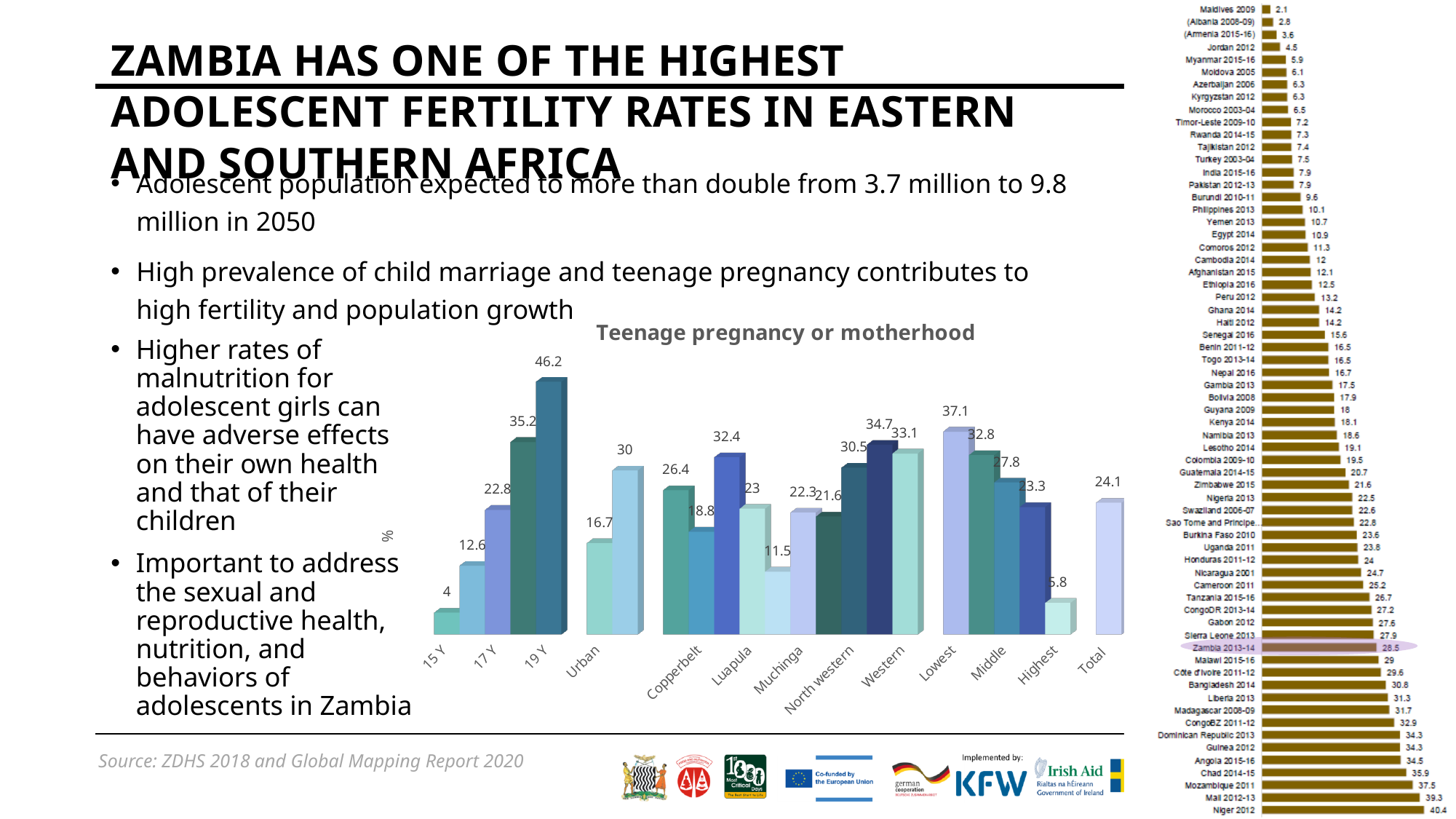
In the 'Teenage pregnancy or motherhood' chart, which category has the highest value? 19 Y What is the title of the bar chart in the centre of the slide? Teenage pregnancy or motherhood In the 'Teenage pregnancy or motherhood' chart, what is the value for Urban? 16.7 In the 'Teenage pregnancy or motherhood' chart, what is the value for 15 Y? 4 In the 'Teenage pregnancy or motherhood' chart, what is the difference between the values for 19 Y and 15 Y? 42.2 In the 'Teenage pregnancy or motherhood' chart, what is the value for Total? 24.1 In the 'Teenage pregnancy or motherhood' chart, what is the value for 19 Y? 46.2 In the horizontal bar chart on the right of the slide, what is the value for Zambia 2013-14? 28.5 In the horizontal bar chart on the right of the slide, which country has the lowest value? Maldives 2009 In the horizontal bar chart on the right of the slide, which country has the highest value? Niger 2012 In the 'Teenage pregnancy or motherhood' chart, what is the value for Lowest? 37.1 In the 'Teenage pregnancy or motherhood' chart, which is larger, the value for Lowest or the value for Total? Lowest